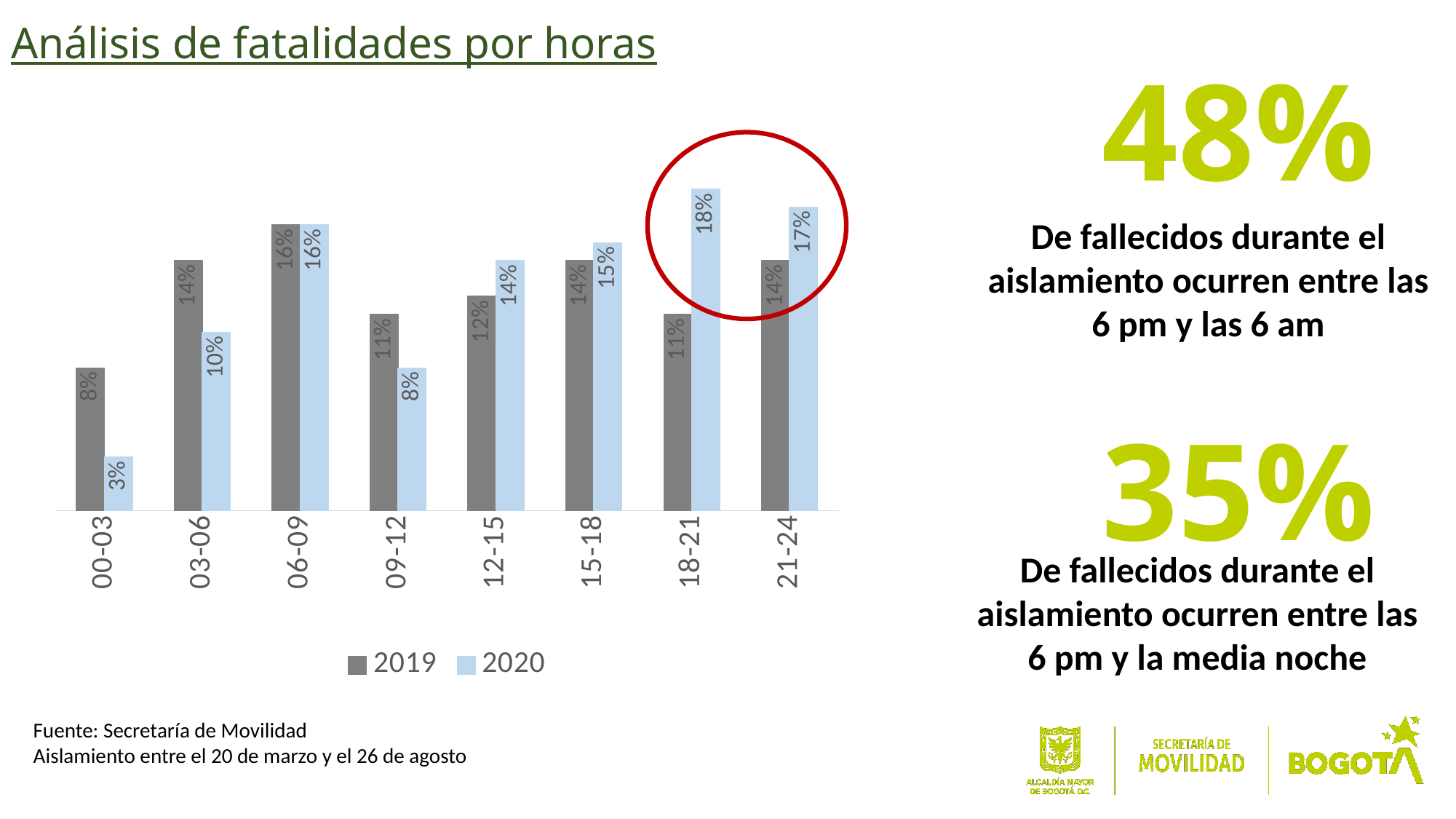
What is the 2020 value for the 18-21 time slot? 18% What kind of chart is shown on the slide? Bar chart Which is larger for the 03-06 time slot, the 2019 value or the 2020 value? 2019 What is the difference between the 2020 and 2019 values for the 18-21 time slot? 7% Which time slot has the lowest 2020 value? 00-03 How many series does the legend list? 2 Which time slot has the highest 2019 value? 06-09 What is the 2019 value for the 00-03 time slot? 8% What is the title of the slide? Análisis de fatalidades por horas How many time slots are shown on the x axis? 8 Which time slot has the highest 2020 value? 18-21 What is the 2020 value for the 09-12 time slot? 8%